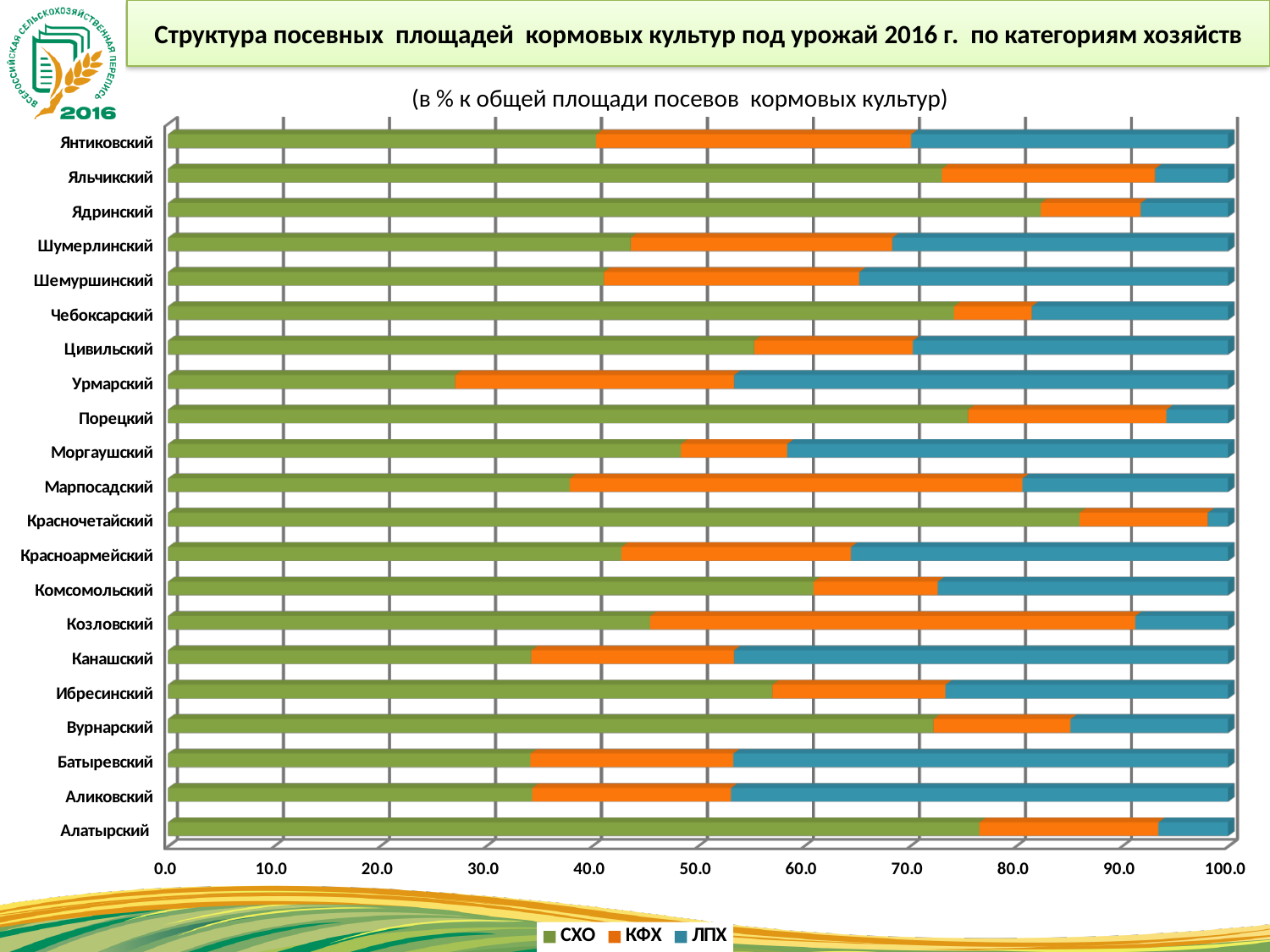
Which district has the smallest СХО share? Урмарский Is the СХО value for Урмарский greater or less than 40.0? less Is the СХО value for Красночетайский greater or less than 80.0? greater Which district has the smallest ЛПХ share? Красночетайский Which district has the largest КФХ share? Козловский Which district has a larger СХО share, Ядринский or Шумерлинский? Ядринский Which colour represents the ЛПХ series? Blue What kind of chart is shown on the slide? Stacked bar chart What are the three series named in the legend? СХО, КФХ, ЛПХ How many districts (categories) are plotted on the chart? 21 Which district has the largest СХО share? Красночетайский How many series does the legend list? 3